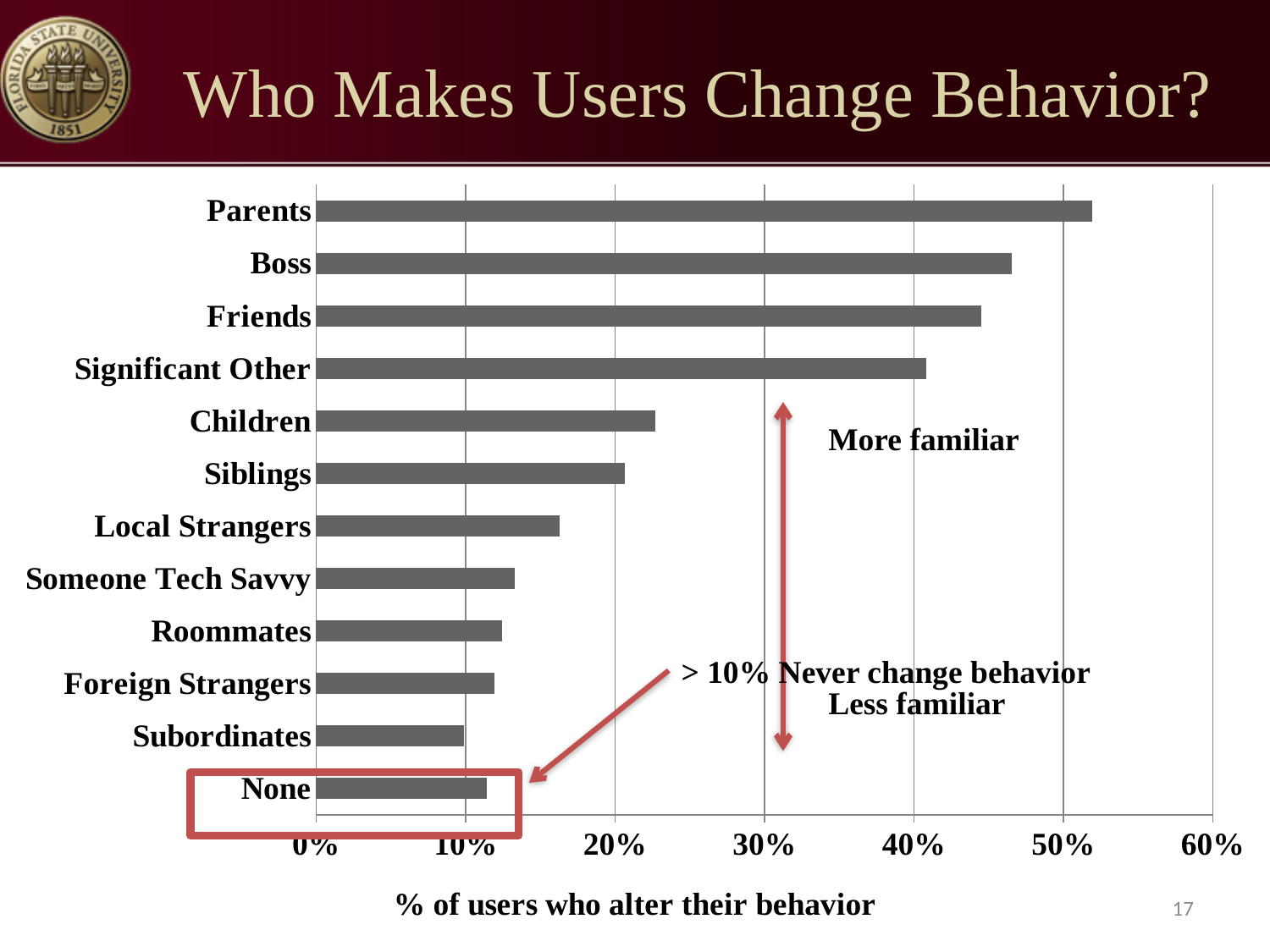
Which category is highlighted with a red box in the chart? None Is the value for Significant Other greater or less than 30%? greater Which has a larger value, Friends or Children? Friends Is the value for Children greater or less than 20%? greater What is the title of the chart's horizontal axis? % of users who alter their behavior Is the value for Local Strangers greater or less than 20%? less What kind of chart is shown on the slide? bar chart Which has a larger value, Parents or Boss? Parents How many categories are plotted in the chart? 12 Which category has the highest value in the chart? Parents